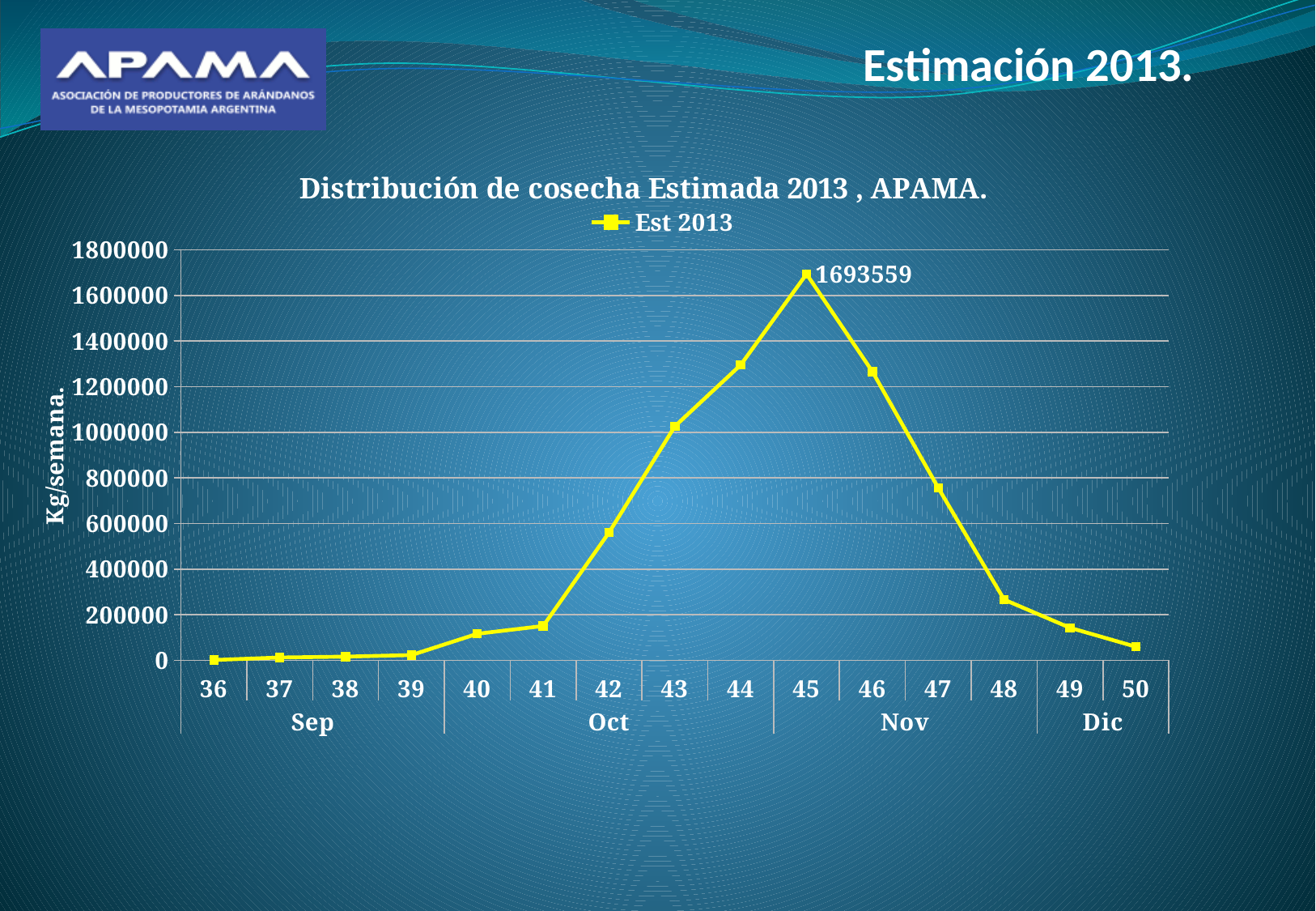
What kind of chart is shown on the slide? line chart What is the estimated value for week 45 in the chart? 1693559 How many weeks are plotted on the x axis? 15 Is the value for week 47 greater or less than 600000? greater Is the value for week 44 greater or less than 1200000? greater Do the values rise or fall from week 45 to week 50? fall Is the value for week 48 greater or less than 200000? greater Which is larger, the value for week 43 or the value for week 47? week 43 Which week has the highest estimated harvest? 45 What is the label on the y axis of the chart? Kg/semana. How many series does the legend list? 1